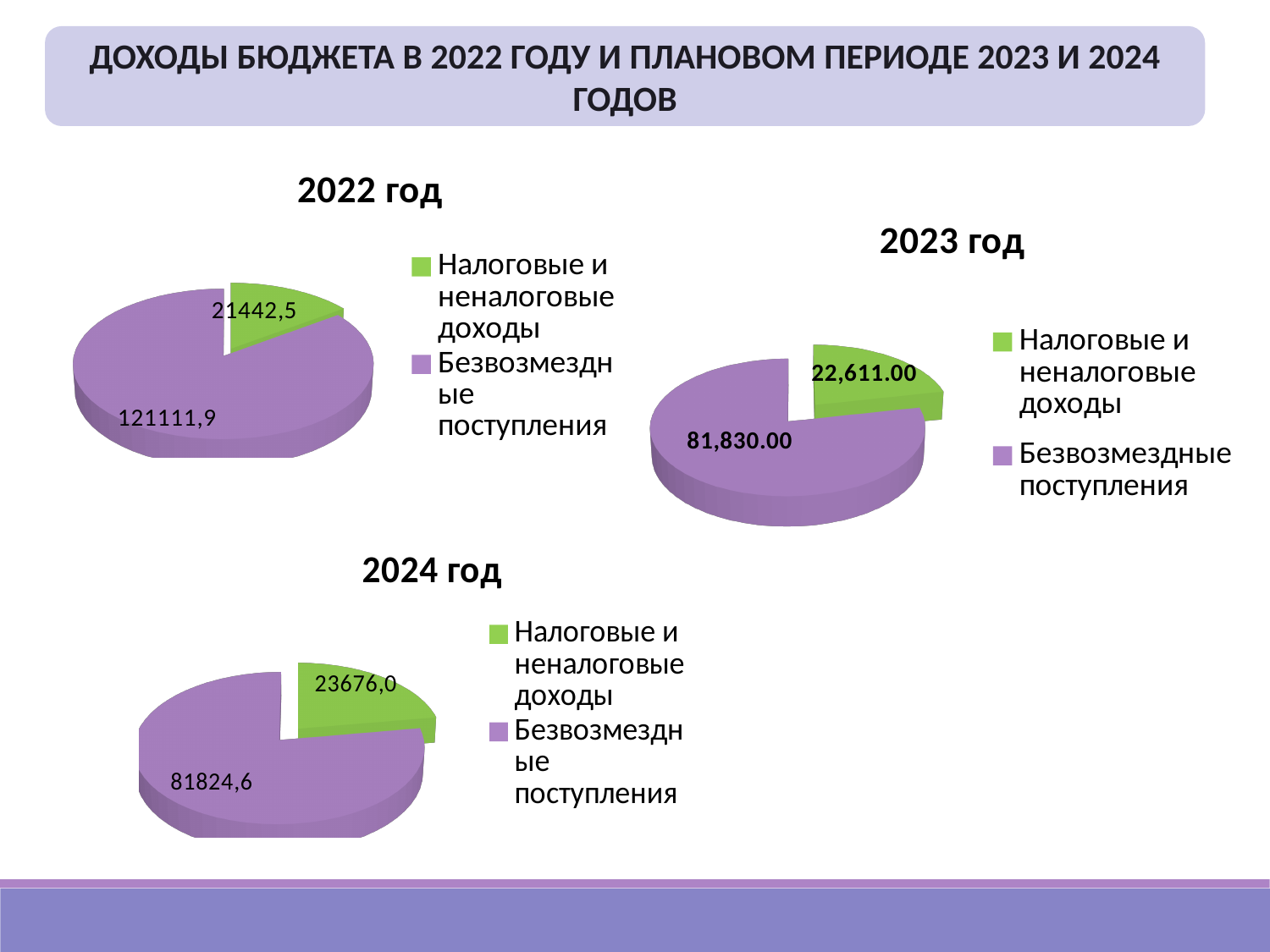
How many series does the legend of the 2024 год chart list? 2 In the 2024 год chart, what is the value for Безвозмездные поступления? 81824,6 In the 2023 год chart, what is the value for Безвозмездные поступления? 81,830.00 In the 2024 год chart, what is the value for Налоговые и неналоговые доходы? 23676,0 In the 2023 год chart, what is the value for Налоговые и неналоговые доходы? 22,611.00 In the 2024 год chart, which category has the smallest slice? Налоговые и неналоговые доходы In the 2022 год chart, which is larger: Налоговые и неналоговые доходы or Безвозмездные поступления? Безвозмездные поступления In the 2022 год chart, what is the value for Безвозмездные поступления? 121111,9 In the 2023 год chart, what is the difference between Безвозмездные поступления and Налоговые и неналоговые доходы? 59,219.00 What type of chart is the 2023 год chart? Pie chart In the 2022 год chart, which category has the largest slice? Безвозмездные поступления In the 2022 год chart, what is the value for Налоговые и неналоговые доходы? 21442,5